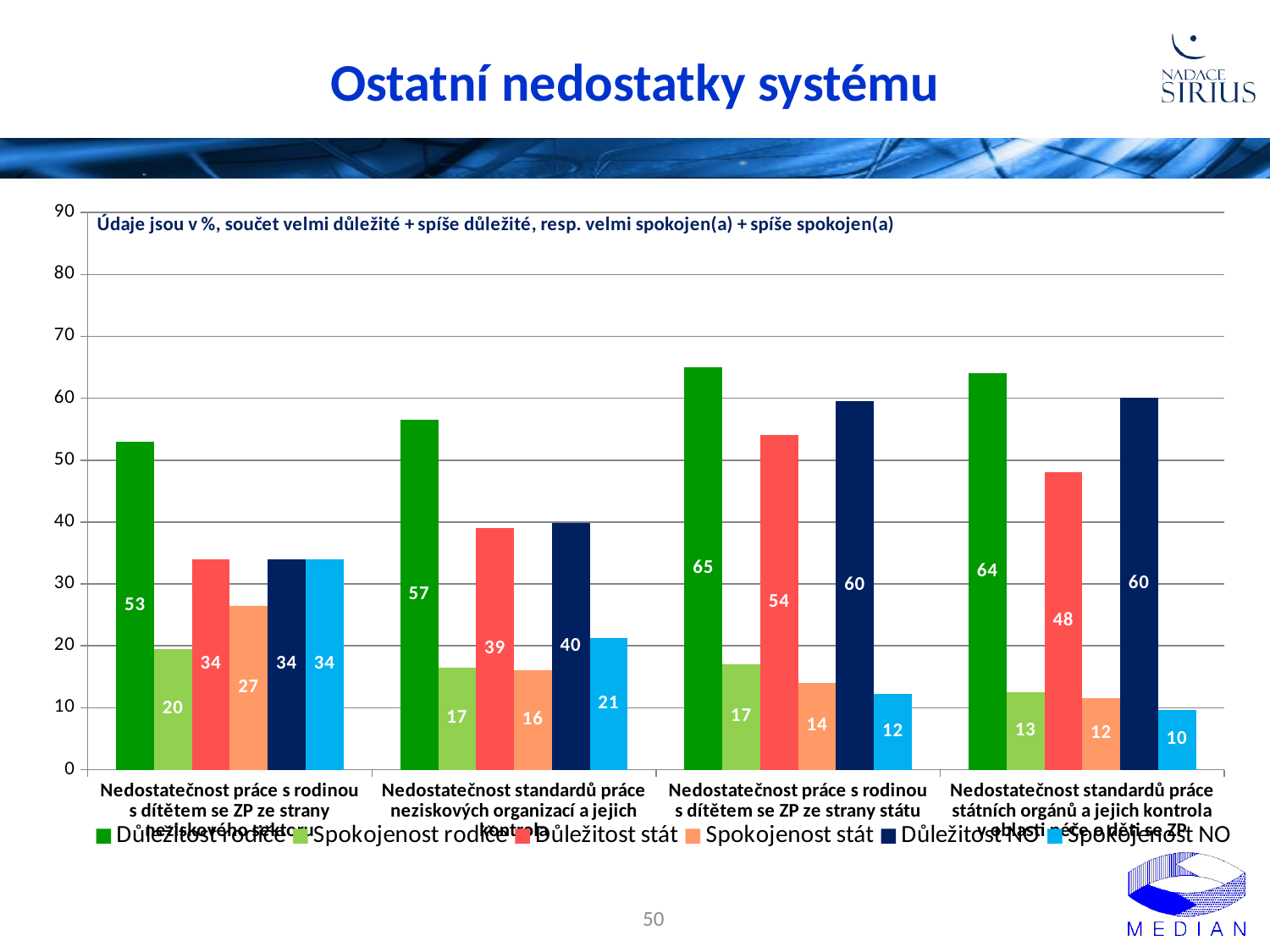
Which category has the highest value for Důležitost rodiče? Nedostatečnost práce s rodinou s dítětem se ZP ze strany státu How many categories are shown on the x axis? 4 What type of chart is shown on the slide? bar chart What is the value of Spokojenost NO for the category 'Nedostatečnost standardů práce neziskových organizací a jejich kontrola'? 21 How many series does the legend list? 6 Is the value of Důležitost rodiče for the category 'Nedostatečnost práce s rodinou s dítětem se ZP ze strany neziskového sektoru' greater or less than 50? greater For the category 'Nedostatečnost standardů práce neziskových organizací a jejich kontrola', which is larger: Důležitost stát or Důležitost NO? Důležitost NO Which category has the lowest value for Spokojenost NO? Nedostatečnost standardů práce státních orgánů a jejich kontrola v oblasti péče o děti se ZP What colour are the bars for the series Důležitost NO? dark blue What is the difference between Důležitost stát and Spokojenost stát for the category 'Nedostatečnost práce s rodinou s dítětem se ZP ze strany státu'? 40 What is the value of Důležitost stát for the category 'Nedostatečnost standardů práce státních orgánů a jejich kontrola v oblasti péče o děti se ZP'? 48 What is the value of Důležitost rodiče for the category 'Nedostatečnost práce s rodinou s dítětem se ZP ze strany státu'? 65